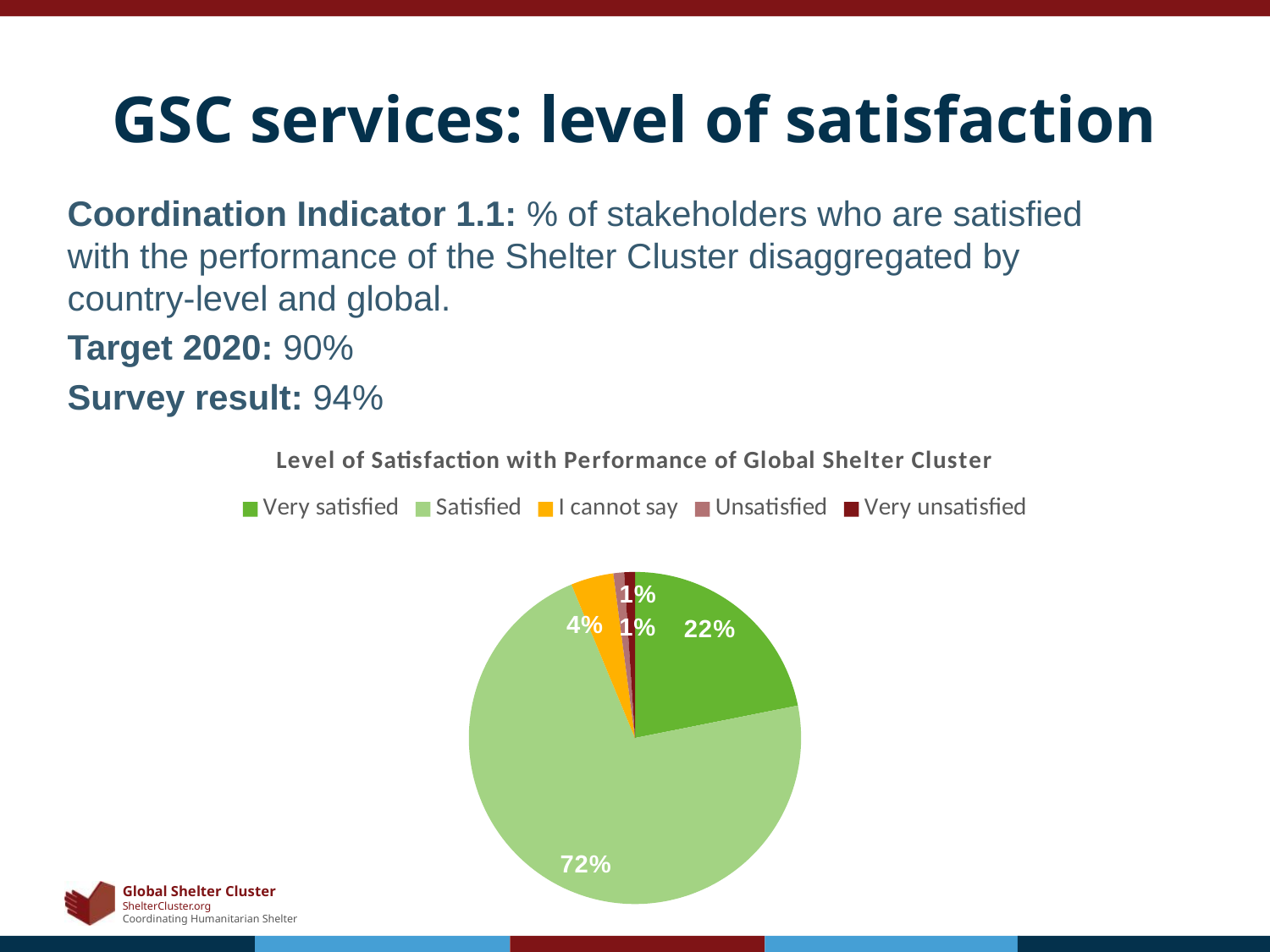
What share of the pie is labelled "Satisfied"? 72% What is the title of the chart? Level of Satisfaction with Performance of Global Shelter Cluster What is the combined share of the "Very satisfied" and "Satisfied" slices? 94% Which category has the largest slice of the pie? Satisfied What type of chart is shown on the slide? Pie chart What colour is the "I cannot say" slice in the pie chart? Orange How many categories does the legend of the pie chart list? 5 What share of the pie is labelled "Very satisfied"? 22% What share of the pie is labelled "Very unsatisfied"? 1% Which slice is larger, "Very satisfied" or "I cannot say"? Very satisfied What is the difference in percentage points between the "Satisfied" and "Very satisfied" slices? 50